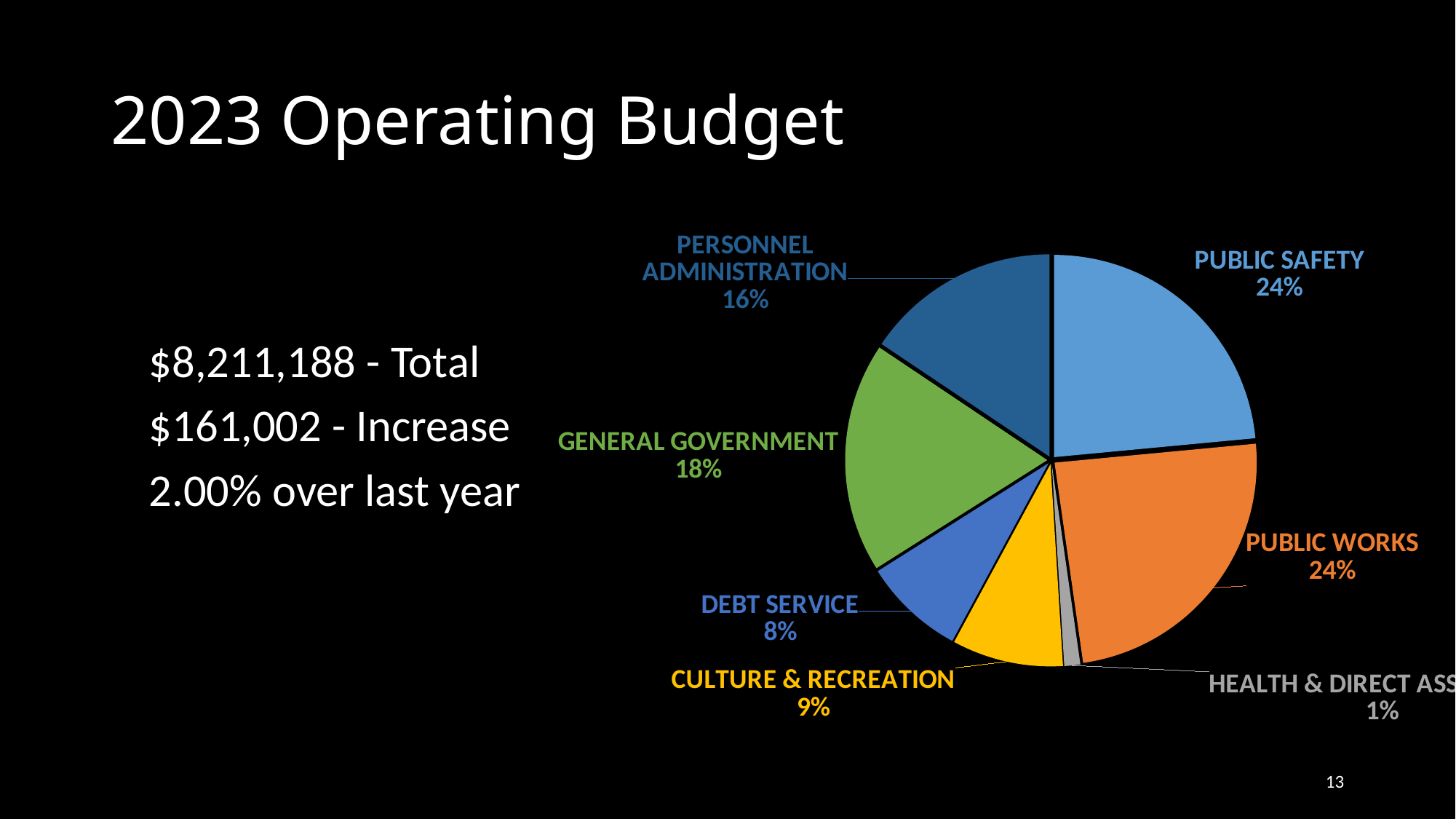
What share of the pie does Debt Service represent? 8% How many slices does the pie chart have? 7 By how many percentage points does Public Safety exceed Culture & Recreation? 15 What colour is the Public Works slice? orange What share of the pie does Public Works represent? 24% What share of the pie does Culture & Recreation represent? 9% What share of the pie does General Government represent? 18% By how many percentage points does General Government exceed Personnel Administration? 2 What kind of chart is shown on the slide? pie chart What share of the pie does Public Safety represent? 24% Which is larger, the share for General Government or the share for Debt Service? General Government What share of the pie does Personnel Administration represent? 16%